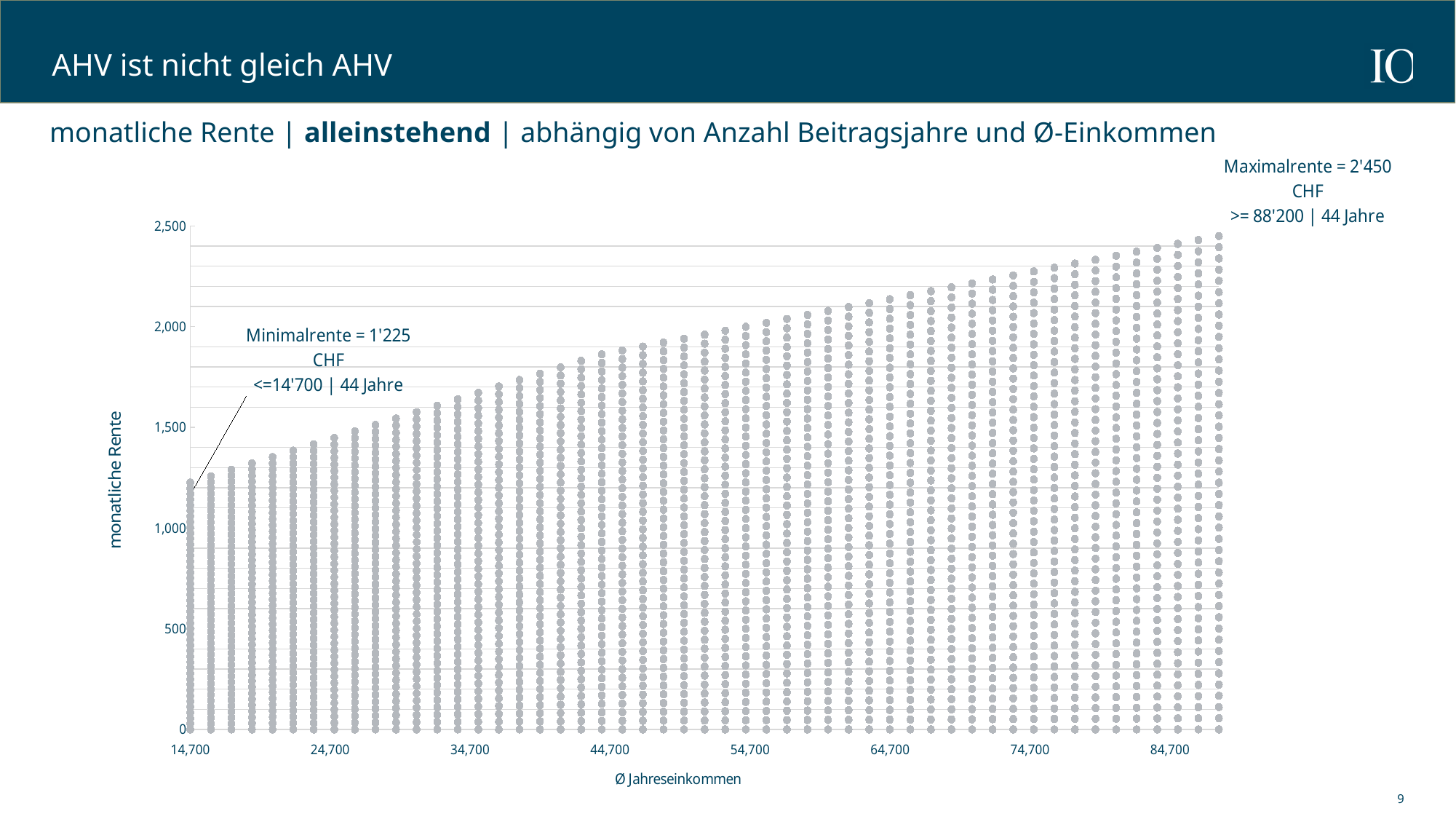
Is the highest monthly pension at an average income of 14,700 greater or less than 1,500? less According to the annotation, what is the Minimalrente? 1'225 CHF What is the difference between the Maximalrente and the Minimalrente shown in the annotations? 1'225 CHF What is the label of the vertical axis? monatliche Rente What kind of chart is shown on the slide? scatter chart According to the annotation, what is the Maximalrente? 2'450 CHF Does the maximum monthly pension rise or fall as the average annual income increases along the x axis? rise At which average income and number of contribution years is the Maximalrente reached, according to the annotation? >= 88'200 | 44 Jahre What is the label of the horizontal axis? Ø Jahreseinkommen At which average income and number of contribution years does the Minimalrente apply, according to the annotation? <=14'700 | 44 Jahre Which is larger: the highest monthly pension at an income of 24,700 or at an income of 64,700? 64,700